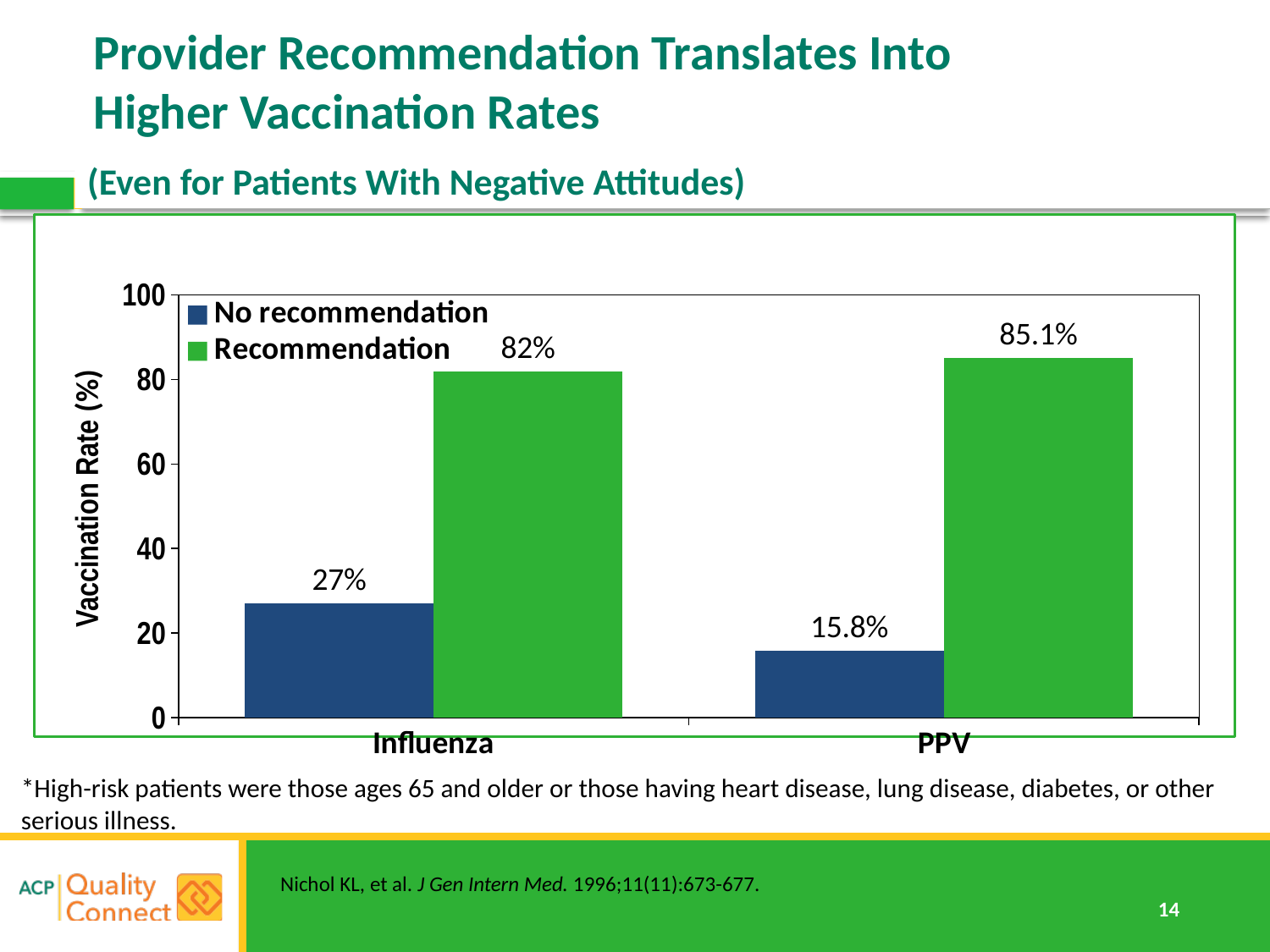
How many series does the legend list? 2 What is the vaccination rate for PPV with a recommendation? 85.1% Which bar shows the lowest vaccination rate on the chart? PPV, No recommendation What is the vaccination rate for PPV with no recommendation? 15.8% What is the vaccination rate for Influenza with a recommendation? 82% What kind of chart is shown on the slide? Bar chart What is the difference between the Recommendation and No recommendation vaccination rates for Influenza? 55 percentage points Which is larger: the No recommendation rate for Influenza or the No recommendation rate for PPV? Influenza Which bar shows the highest vaccination rate on the chart? PPV, Recommendation How many vaccine categories are shown on the x axis? 2 What is the label of the y axis? Vaccination Rate (%) What is the vaccination rate for Influenza with no recommendation? 27%